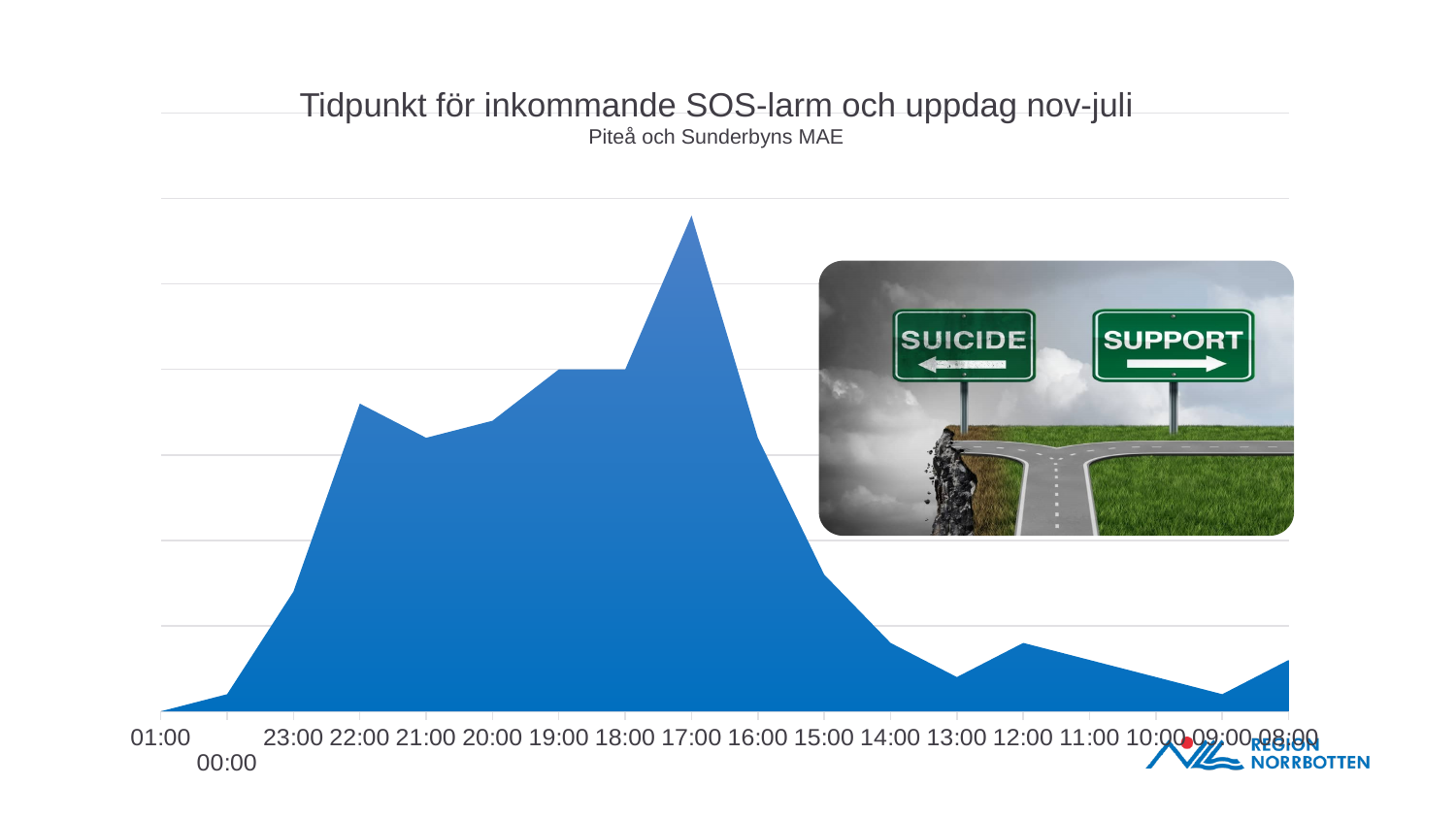
Which has the larger value, 19:00 or 20:00? 19:00 What is the subtitle shown under the chart title? Piteå och Sunderbyns MAE Do the values generally rise or fall from 01:00 to 17:00 along the x axis? Rise What kind of chart is shown on the slide? Area chart How many time categories are shown on the x axis? 18 Which has the larger value, 17:00 or 14:00? 17:00 Which has the larger value, 22:00 or 21:00? 22:00 At which time is the value lowest? 01:00 What is the title of the chart? Tidpunkt för inkommande SOS-larm och uppdag nov-juli Do the values generally rise or fall from 17:00 to 10:00 along the x axis? Fall At which time is the value highest? 17:00